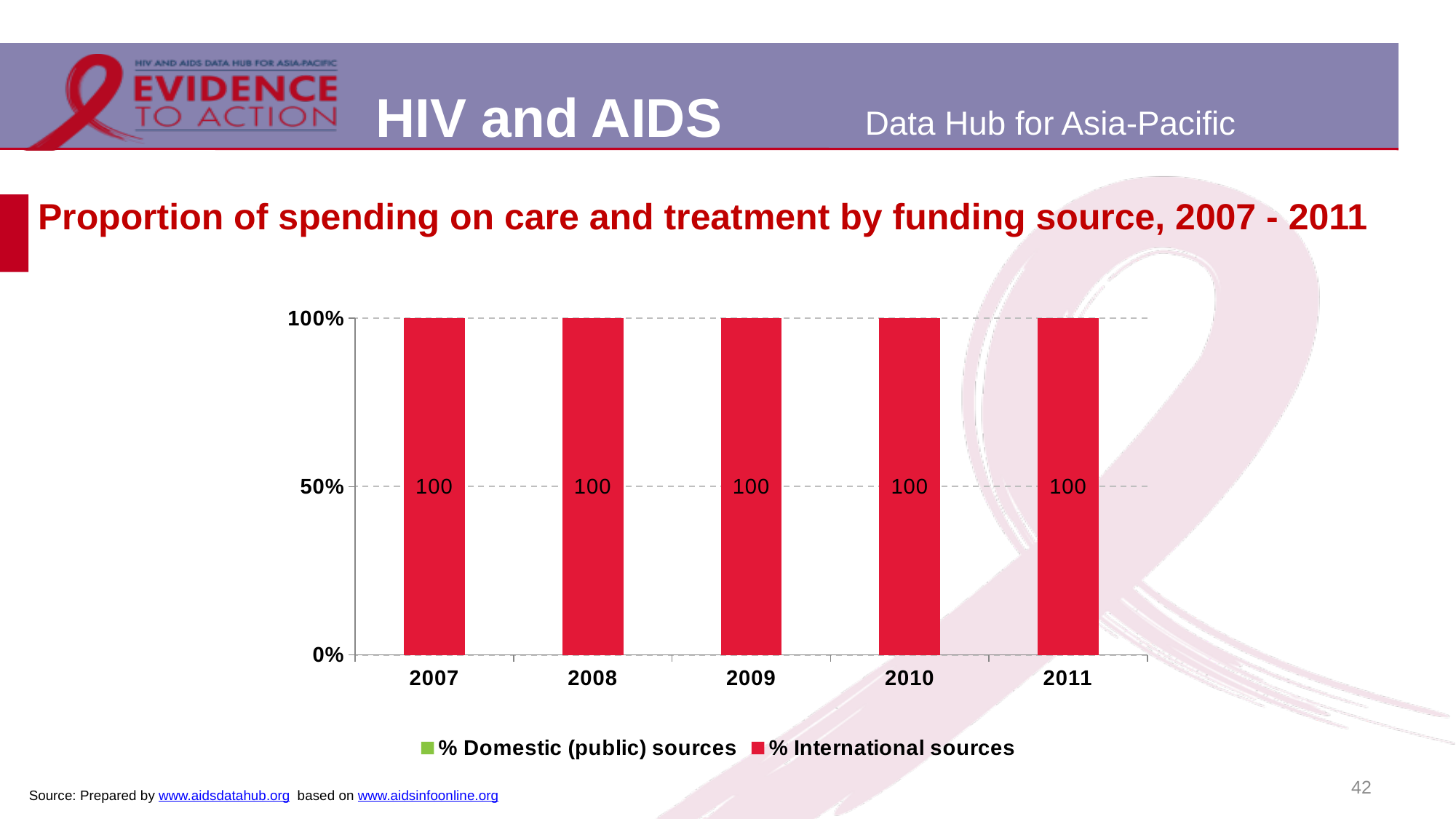
Does the value for % International sources rise, fall or stay the same from 2007 to 2011? stays the same How many series does the legend list? 2 Which series is shown in red in the legend? % International sources What is the value for % International sources in 2009? 100 What kind of chart is shown on the slide? bar chart What is the value for % International sources in 2007? 100 What is the highest value shown on the y axis? 100% What is the title of the chart? Proportion of spending on care and treatment by funding source, 2007 - 2011 What is the difference between the % International sources values for 2008 and 2010? 0 Is the value for % International sources in 2010 greater or less than 50%? greater What is the value for % International sources in 2011? 100 How many years are shown on the x axis? 5